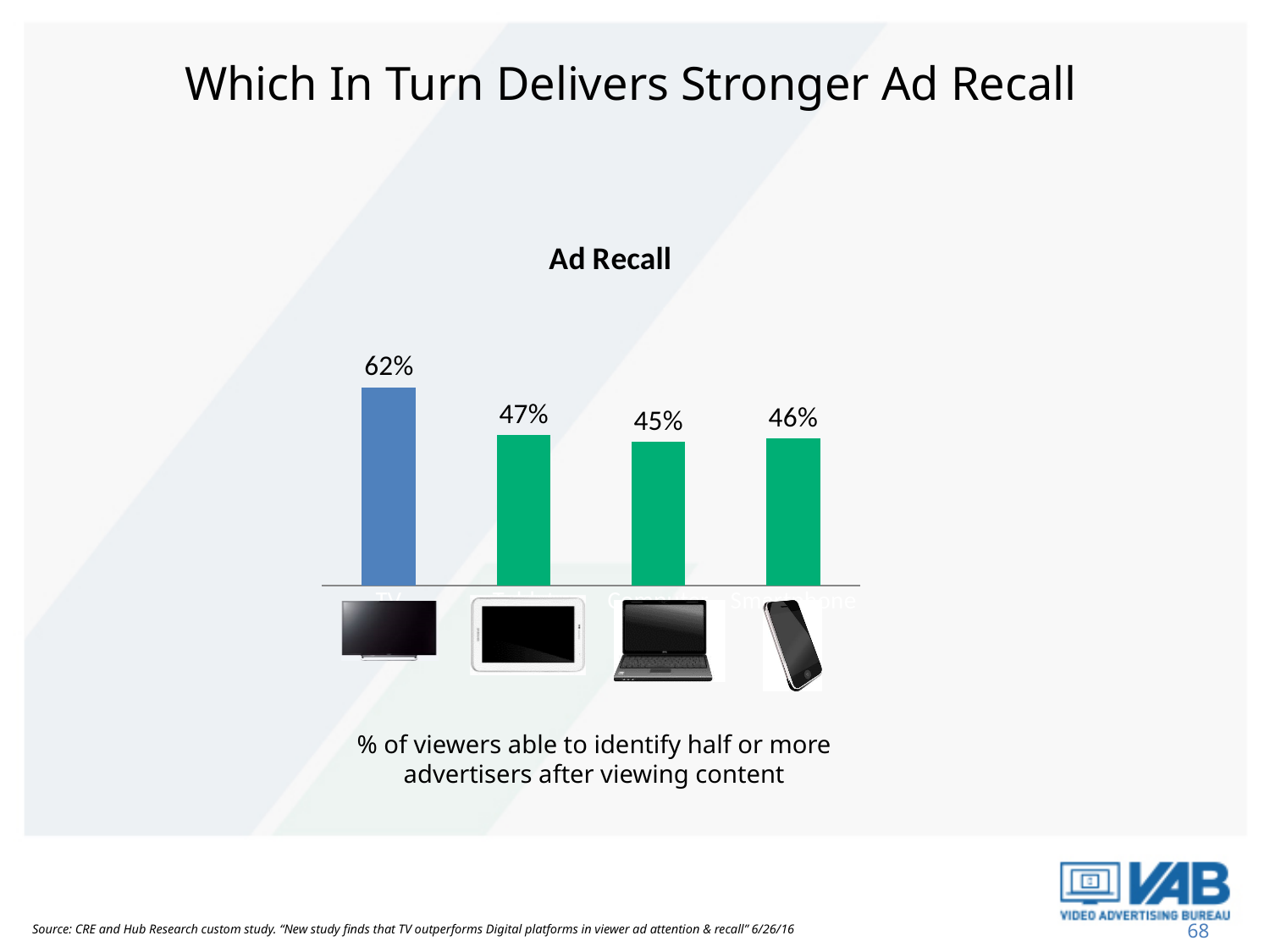
What is the value of the second bar from the left (above the tablet image) in the Ad Recall chart? 47% What is the title of the chart? Ad Recall What is the value of the leftmost bar (above the TV image) in the Ad Recall chart? 62% Which bar has the lowest value in the Ad Recall chart? the third bar from the left (laptop), 45% What is the value of the rightmost bar (above the smartphone image) in the Ad Recall chart? 46% What is the difference between the leftmost bar (62%) and the second bar (47%) in the Ad Recall chart? 15 percentage points Which bar has the highest value in the Ad Recall chart? the leftmost bar (TV), 62% What type of chart is shown on the slide? bar chart Which is larger in the Ad Recall chart: the leftmost bar or the rightmost bar? the leftmost bar (62%) What is the value of the third bar from the left (above the laptop image) in the Ad Recall chart? 45% How many bars are plotted in the Ad Recall chart? 4 What colour is the leftmost bar in the Ad Recall chart, compared with the other three bars? blue; the other three are green